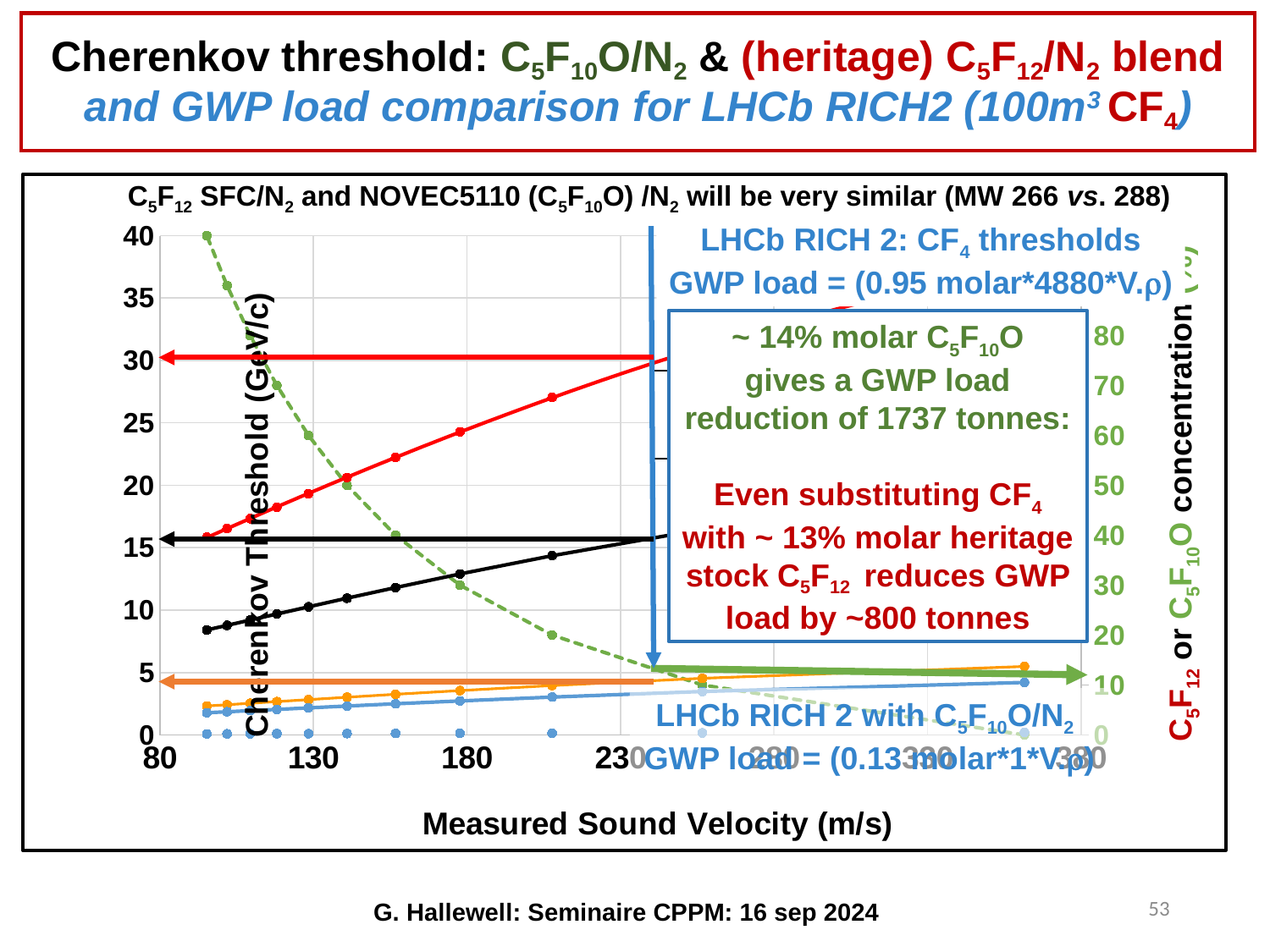
At a measured sound velocity of 180 m/s, is the Cherenkov threshold on the solid black line greater or less than 15? less Does the solid red line rise or fall as the measured sound velocity increases? rises At a measured sound velocity of 180 m/s, which line has the higher Cherenkov threshold, the solid red line or the solid black line? the solid red line At a measured sound velocity of 180 m/s, is the Cherenkov threshold on the solid red line greater or less than 20? greater What is the title of the left vertical axis of the chart? Cherenkov Threshold (GeV/c) At a measured sound velocity of 130 m/s, is the Cherenkov threshold on the solid black line greater or less than 5? greater Does the dashed green line rise or fall as the measured sound velocity increases? falls What is the title of the horizontal axis of the chart? Measured Sound Velocity (m/s) What kind of chart is shown on the slide? line chart Does the solid black line rise or fall as the measured sound velocity increases? rises What is the highest tick value shown on the left vertical axis? 40